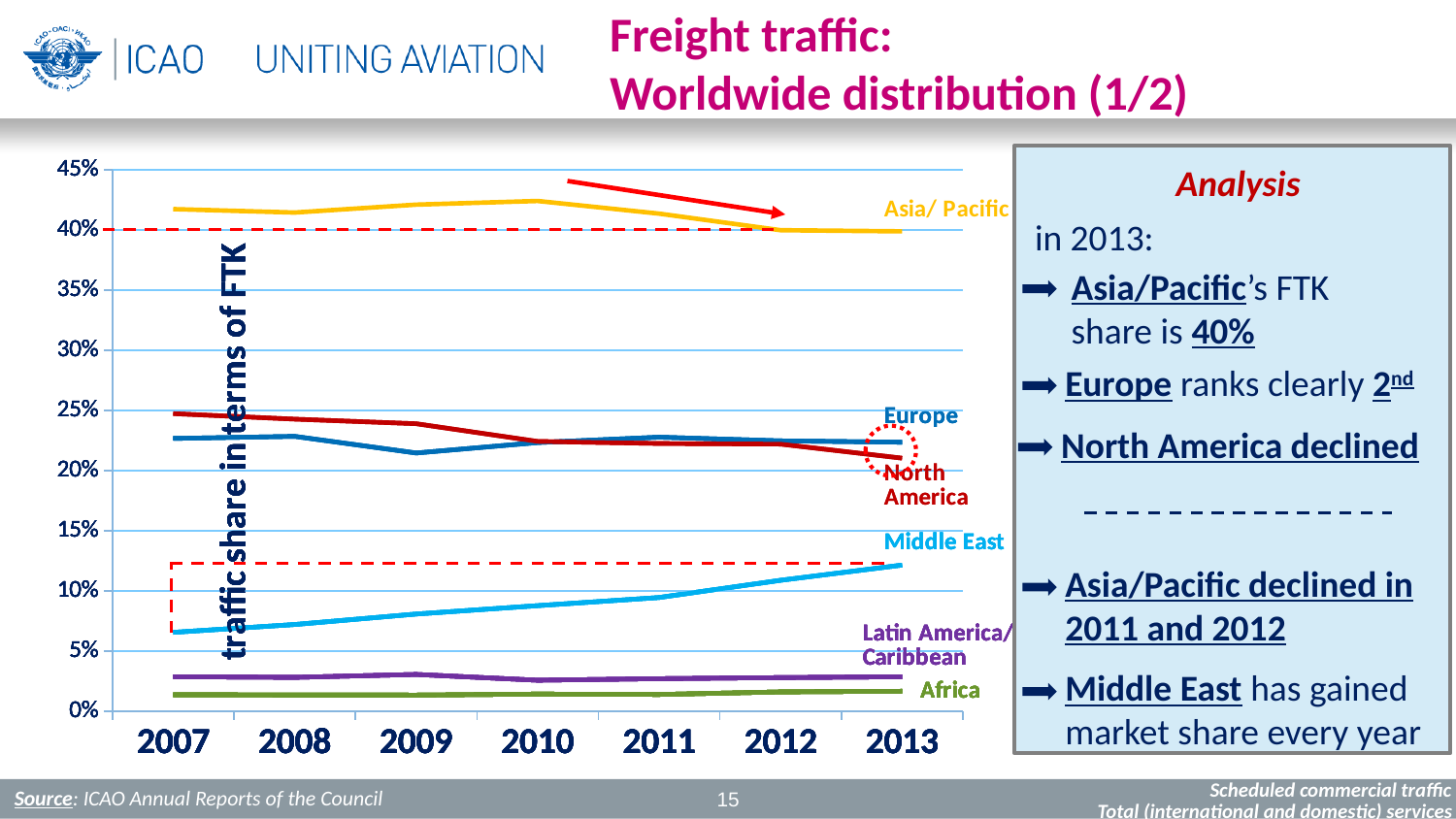
Does the Middle East's traffic share rise or fall from 2007 to 2013? rise What is Asia/Pacific's FTK share in 2013? 40% Which region has the lowest traffic share in 2013? Africa What is the label on the y axis of the chart? traffic share in terms of FTK Which region has the highest traffic share in 2013? Asia/Pacific How many years are shown on the x axis of the chart? 7 Is the value for Asia/Pacific in 2007 greater or less than 40%? greater In 2007, which has the larger traffic share, North America or Europe? North America In 2013, which has the larger traffic share, Europe or North America? Europe How many regions (series) are plotted on the chart? 6 What kind of chart is shown on the slide? line chart Is the value for Middle East in 2013 greater or less than 10%? greater